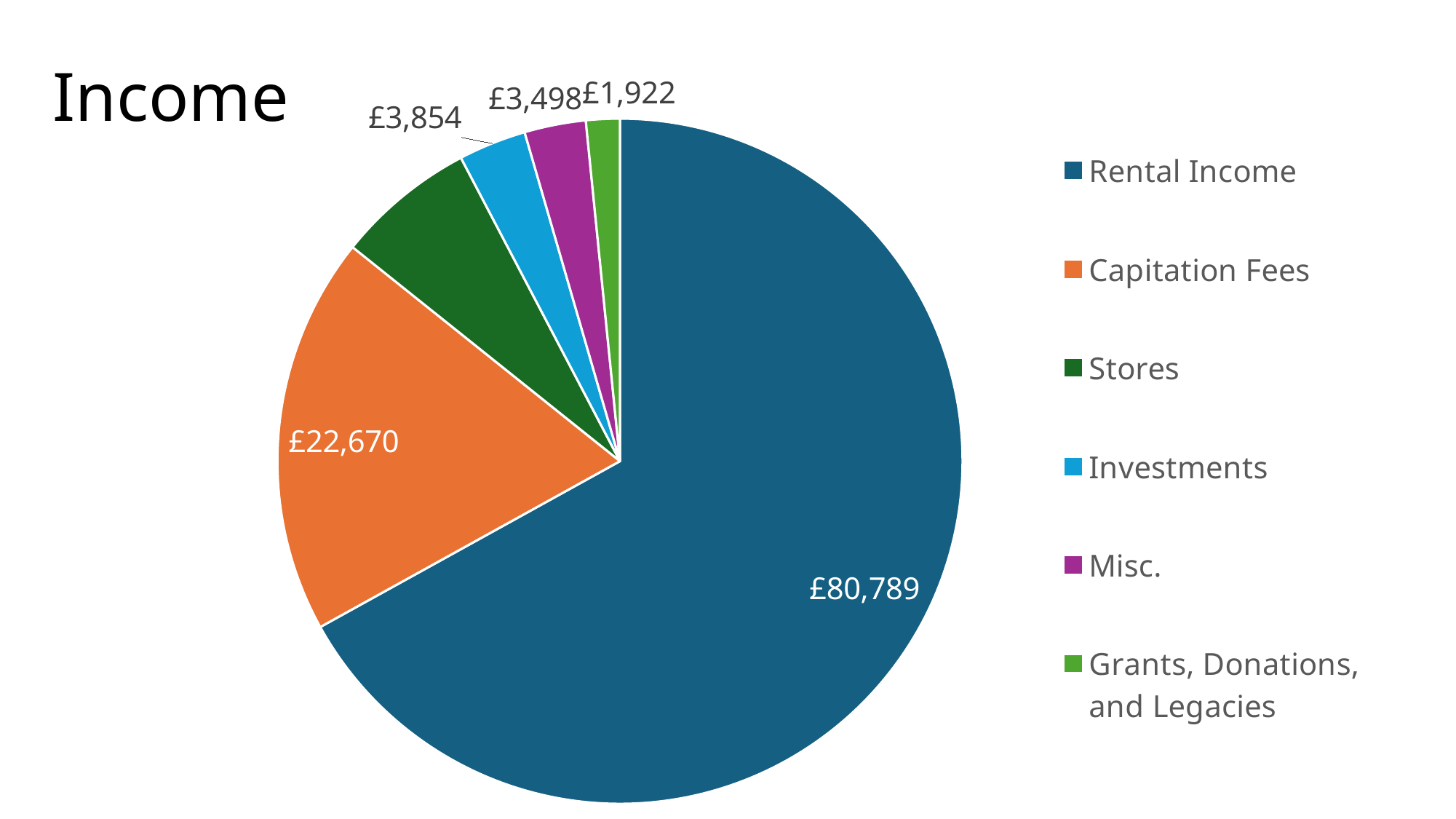
What type of chart is shown on the slide? pie chart What is the difference between Rental Income and Capitation Fees? £58,119 Which category has the largest slice of the pie? Rental Income Which is larger, Investments or Misc.? Investments What is the title of the chart? Income How many categories does the pie chart show? 6 What is the value for Rental Income? £80,789 What is the value for Capitation Fees? £22,670 What is the value for Misc.? £3,498 What is the value for Investments? £3,854 What is the value for Grants, Donations, and Legacies? £1,922 Which category has the smallest slice of the pie? Grants, Donations, and Legacies